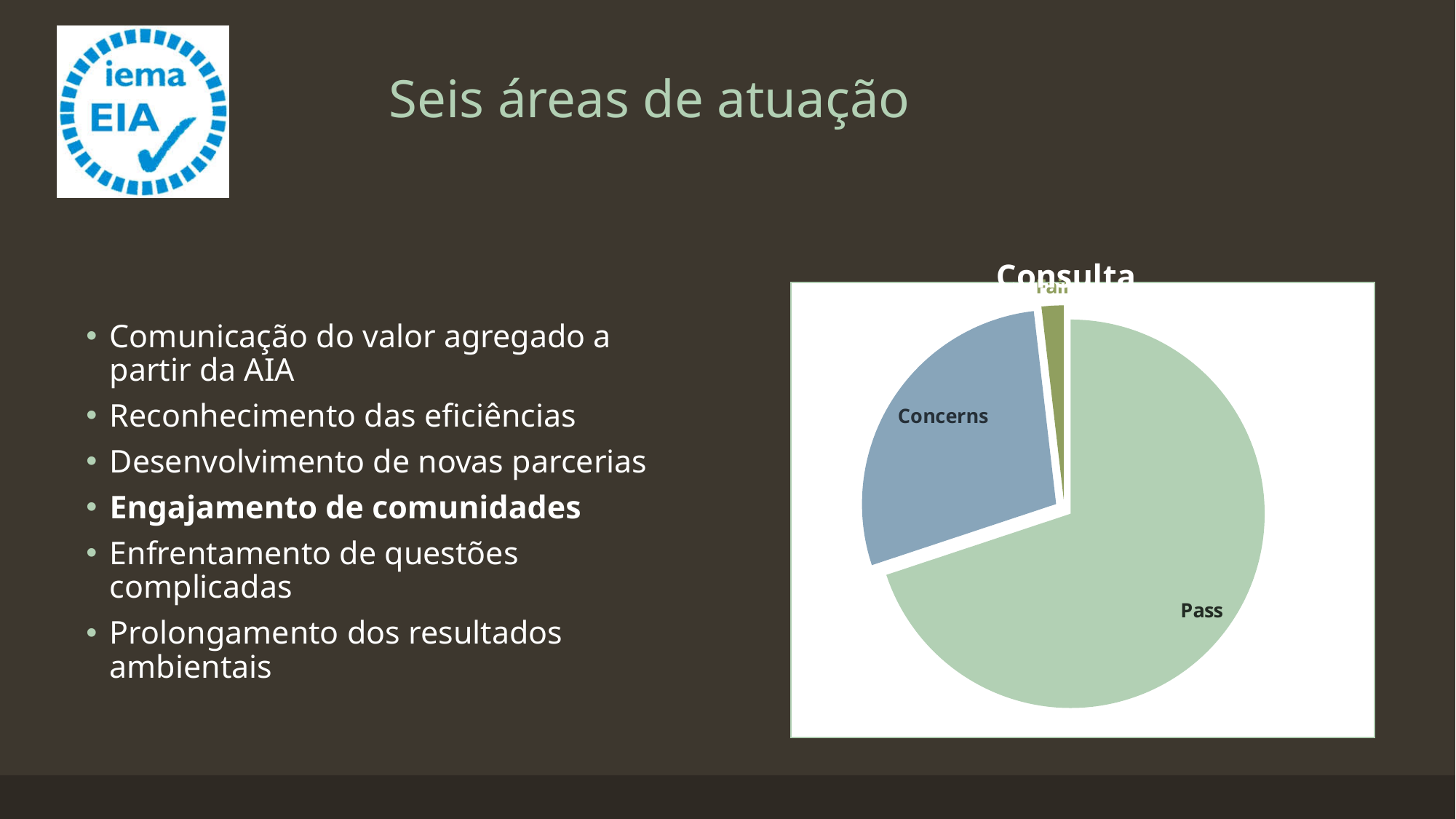
Which slice of the pie chart is the smallest? Fail Which slice is larger in the pie chart, Pass or Concerns? Pass What is the title of the pie chart? Consulta What kind of chart is shown on the slide? pie chart What colour is the Pass slice in the pie chart? light green Which slice of the pie chart is the largest? Pass How many slices does the pie chart have? 3 Does the Pass slice take up more or less than half of the pie chart? more Which slice is larger in the pie chart, Concerns or Fail? Concerns